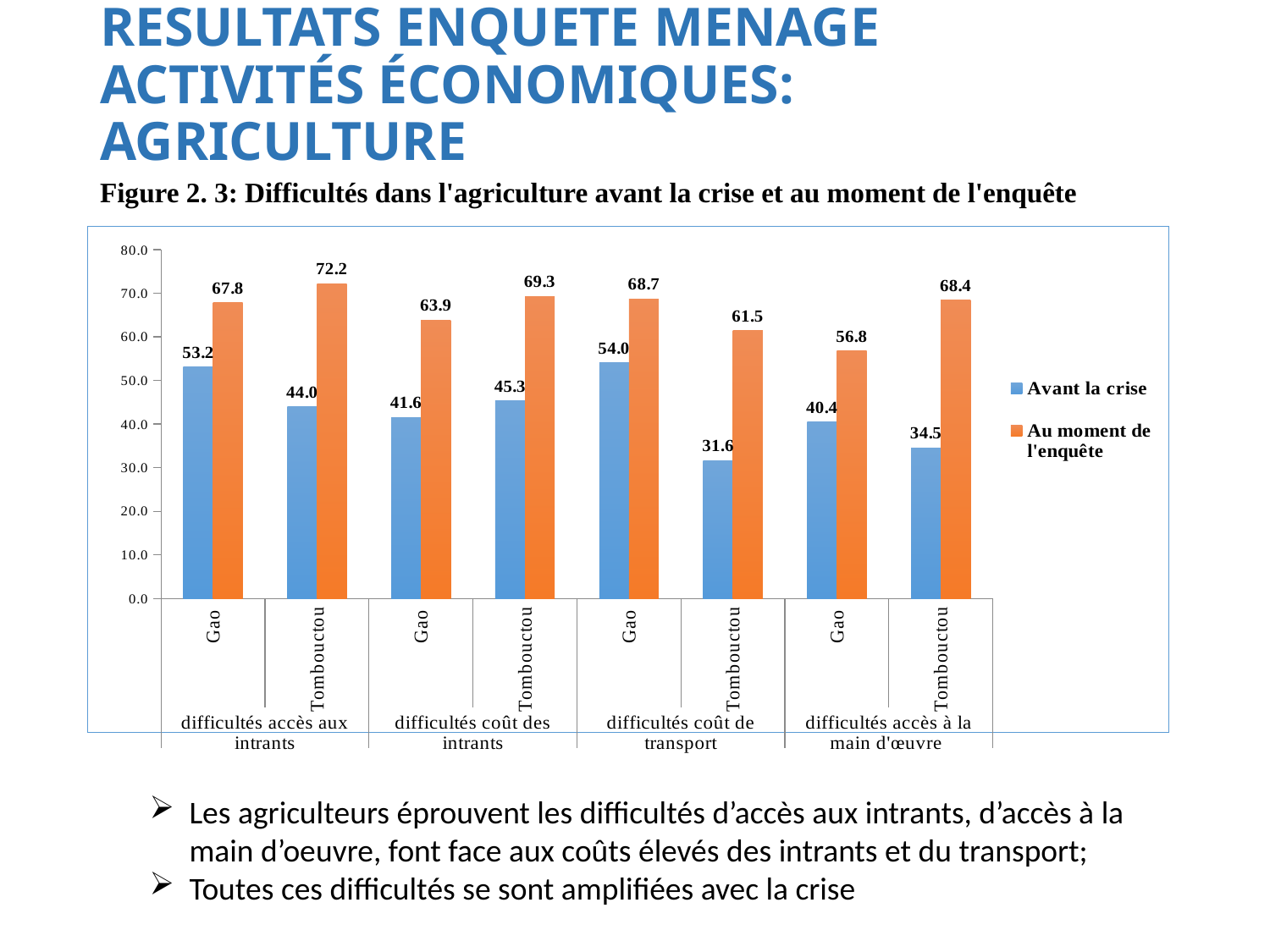
How many series does the legend list? 2 What is the value for 'Au moment de l'enquête' for Tombouctou under 'difficultés accès aux intrants'? 72.2 Which bar group has the highest 'Au moment de l'enquête' value? Tombouctou, difficultés accès aux intrants Which is larger for Tombouctou under 'difficultés coût des intrants': 'Avant la crise' or 'Au moment de l'enquête'? Au moment de l'enquête What colour represents the 'Avant la crise' series? Blue What is the value for 'Avant la crise' for Tombouctou under 'difficultés coût de transport'? 31.6 What is the value for 'Au moment de l'enquête' for Gao under 'difficultés accès à la main d'œuvre'? 56.8 What is the value for 'Avant la crise' for Gao under 'difficultés accès aux intrants'? 53.2 How many bar groups (region-difficulty combinations) are shown on the x axis? 8 Which bar group has the lowest 'Avant la crise' value? Tombouctou, difficultés coût de transport What kind of chart is shown on the slide? Bar chart What is the difference between the 'Au moment de l'enquête' and 'Avant la crise' values for Gao under 'difficultés coût des intrants'? 22.3